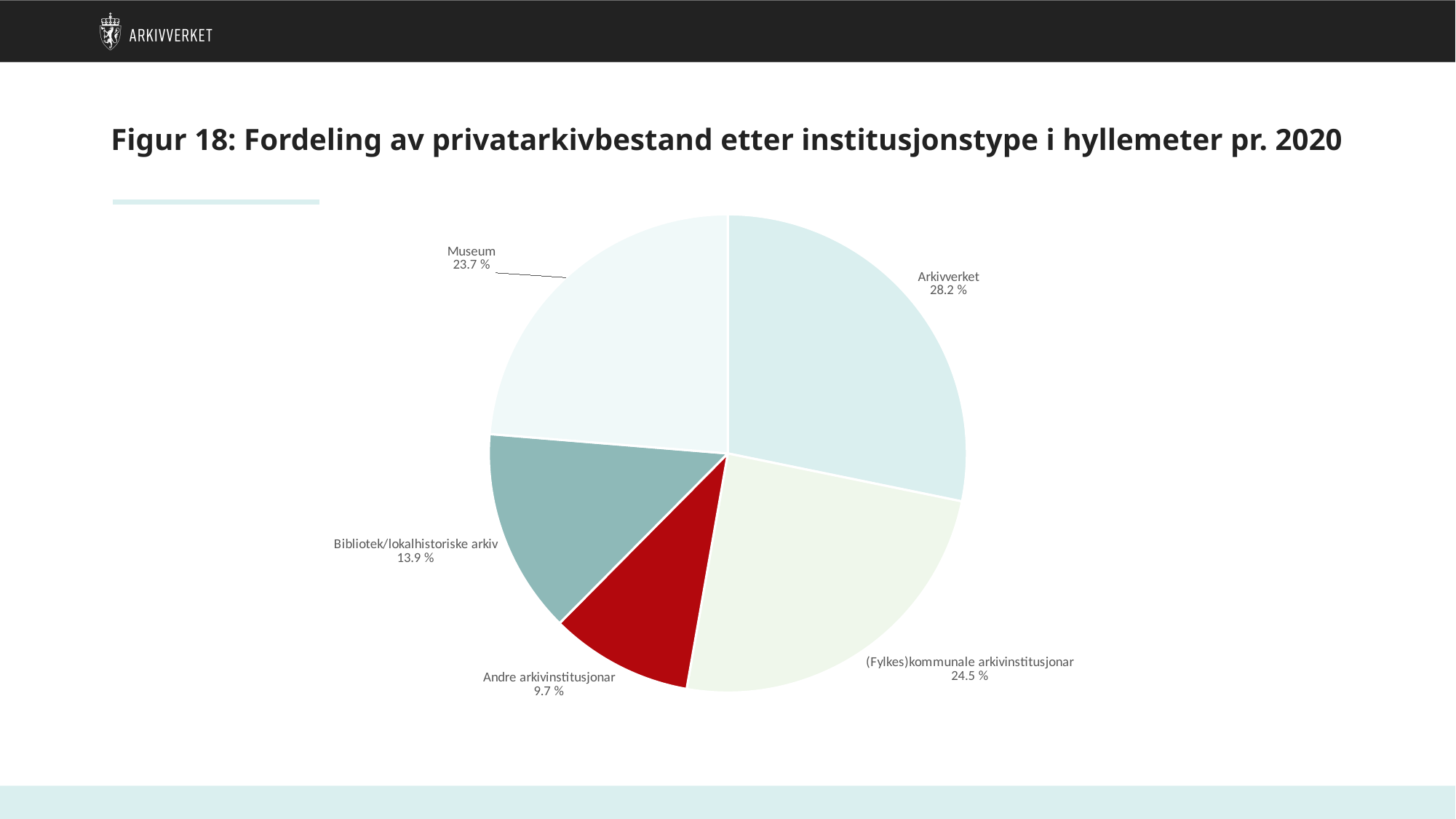
What share of the pie does Bibliotek/lokalhistoriske arkiv hold? 13.9 % What share of the pie does Andre arkivinstitusjonar hold? 9.7 % What share of the pie does Arkivverket hold? 28.2 % Which category has the largest share of the pie? Arkivverket Which is larger, the share for Bibliotek/lokalhistoriske arkiv or the share for Andre arkivinstitusjonar? Bibliotek/lokalhistoriske arkiv How many slices does the pie chart have? 5 What is the difference in percentage points between Arkivverket and Museum? 4.5 What type of chart is shown on the slide? Pie chart What is the title of the chart on the slide? Figur 18: Fordeling av privatarkivbestand etter institusjonstype i hyllemeter pr. 2020 Which category has the smallest share of the pie? Andre arkivinstitusjonar